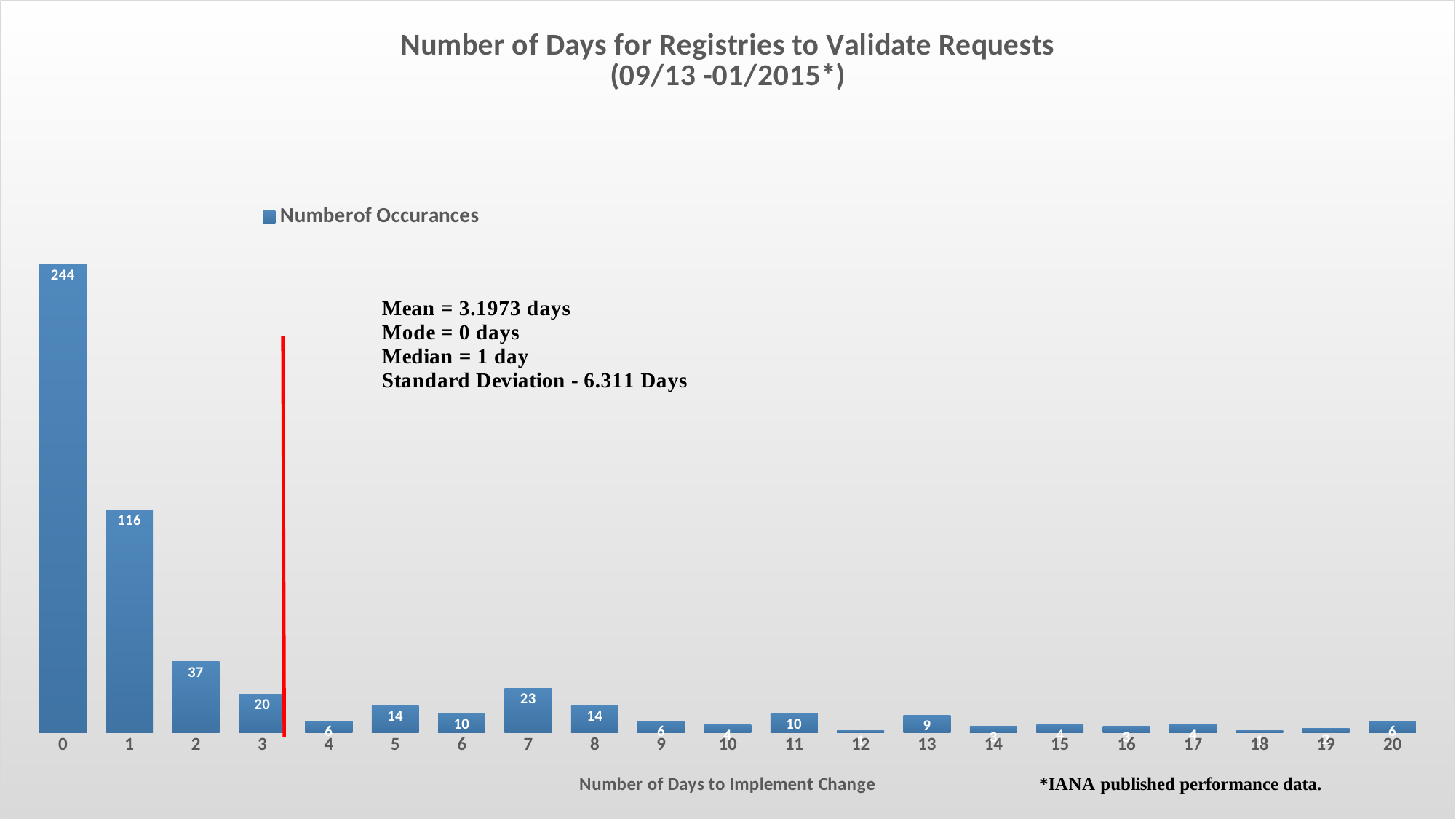
How many series does the legend list? 1 What is the difference between the occurrences for 0 days and 1 day? 128 What is the number of occurrences for 1 day? 116 Which has more occurrences, 2 days or 3 days? 2 days Which number of days has the highest number of occurrences? 0 How many occurrences are shown for 0 days? 244 What is the value of the bar for 7 days? 23 What is the x-axis title of the chart? Number of Days to Implement Change What kind of chart is shown on the slide? Bar chart How many categories (day values) are shown on the x axis? 21 Do the values generally rise or fall as the number of days increases from 0 to 4? Fall What is the value of the bar for 2 days? 37